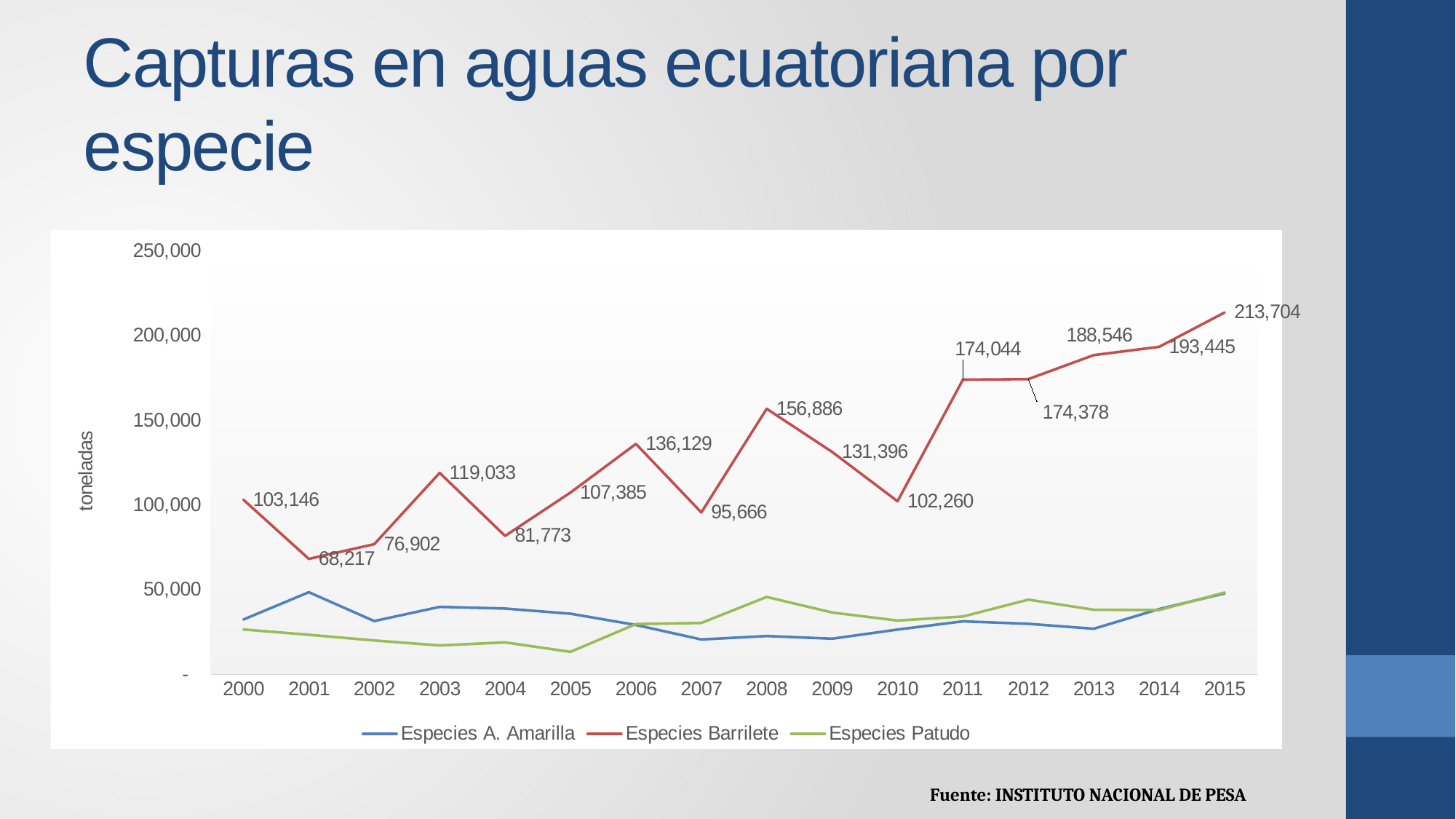
Does the Especies Barrilete catch rise or fall from 2011 to 2015? rise What type of chart is shown on the slide? line chart Is the value for Especies Patudo in 2005 greater or less than 50,000? less How many years are shown on the x axis? 16 What unit is shown on the y axis label? toneladas What is the difference between the Especies Barrilete catch in 2015 and in 2000? 110,558 How many series does the legend list? 3 What was the catch of Especies Barrilete in 2008? 156,886 Which year had a larger Especies Barrilete catch, 2003 or 2006? 2006 In which year was the catch of Especies Barrilete lowest? 2001 What was the catch of Especies Barrilete in 2015? 213,704 In which year was the catch of Especies Barrilete highest? 2015